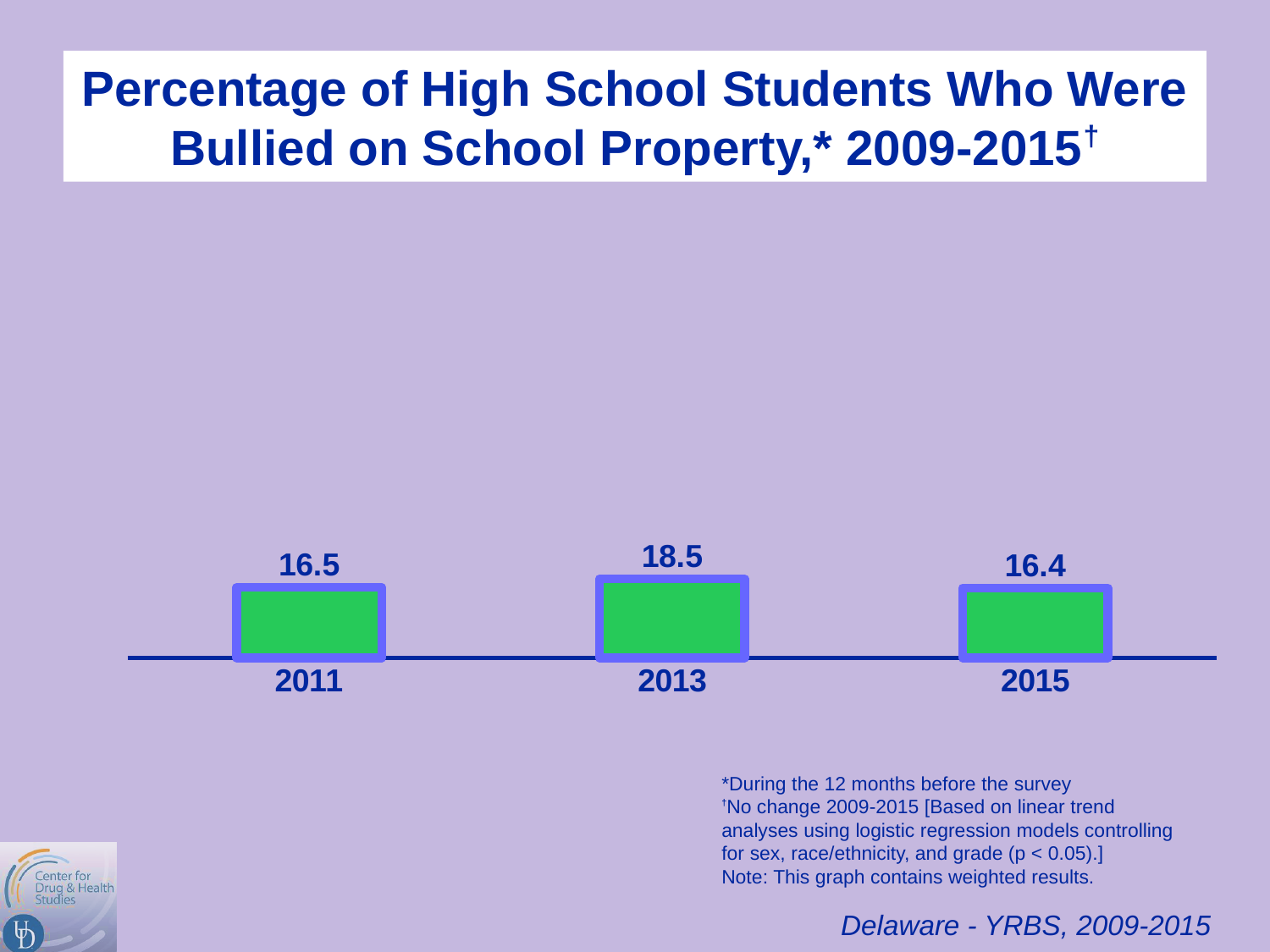
What is the value for 2011? 16.5 What is the value for 2013? 18.5 Which year has the lowest percentage? 2015 What is the value for 2015? 16.4 How many years are shown on the chart? 3 What is the title of the chart? Percentage of High School Students Who Were Bullied on School Property,* 2009-2015 What kind of chart is this? bar chart Which year has the highest percentage? 2013 Which is larger, the value for 2011 or the value for 2013? 2013 What is the difference between the values for 2013 and 2011? 2.0 What is the difference between the values for 2013 and 2015? 2.1 Does the value rise or fall from 2013 to 2015? fall